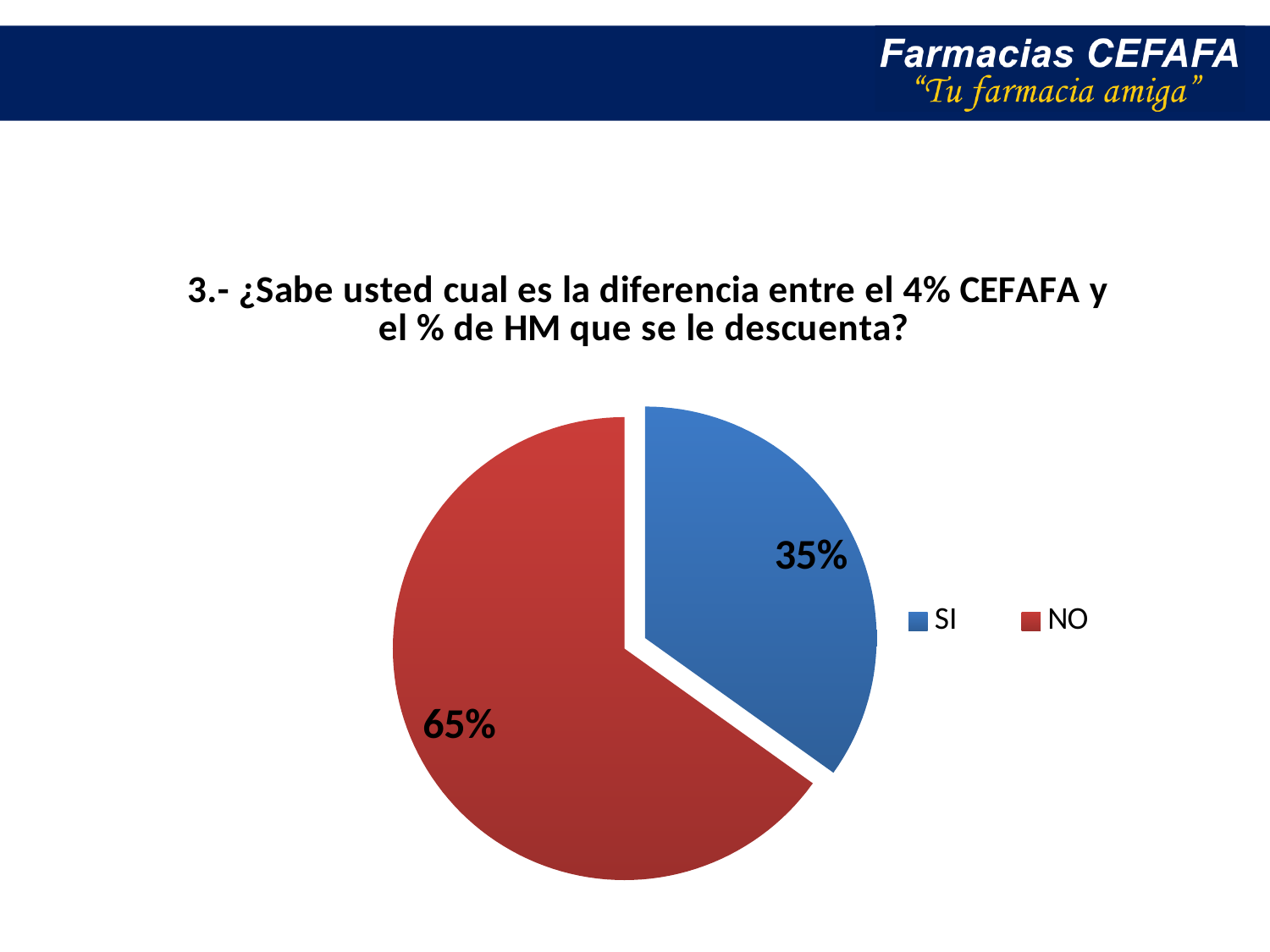
What is the difference in percentage points between the NO slice and the SI slice? 30% Which category has the smallest slice of the pie? SI Which category has the largest slice of the pie? NO Which slice is larger, SI or NO? NO What colour is the SI slice? blue What share of the pie does the SI slice represent? 35% What kind of chart is shown on the slide? pie chart What colour is the NO slice? red What share of the pie does the NO slice represent? 65% How many slices does the pie chart have? 2 How many entries does the legend list? 2